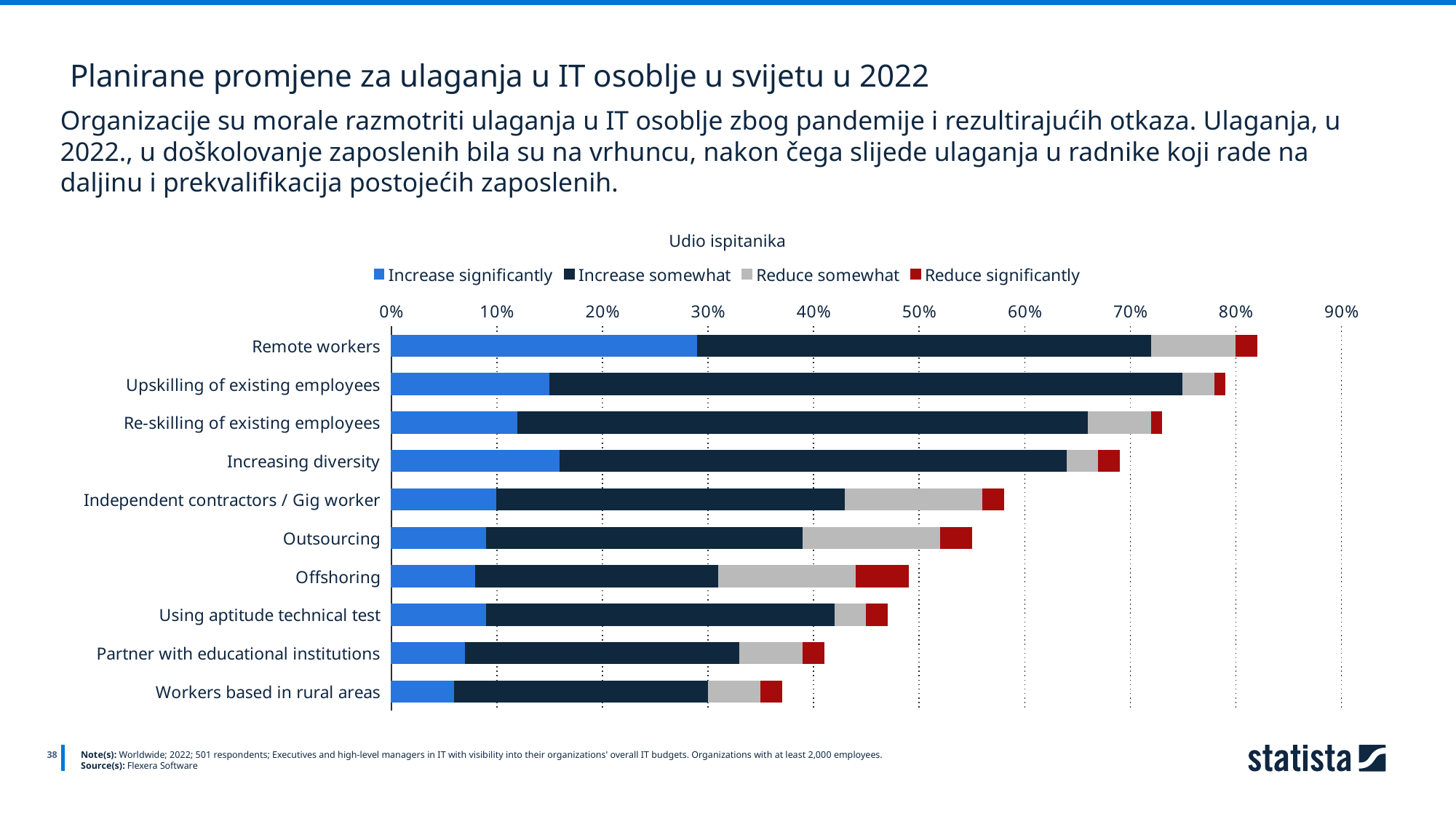
What kind of chart is shown on the slide? Stacked bar chart Which category has the shortest total bar? Workers based in rural areas How many categories are plotted on the chart? 10 Is the 'Increase significantly' value for Workers based in rural areas greater or less than 10%? less Is the 'Increase significantly' value for Remote workers greater or less than 20%? greater Which is larger, the 'Increase significantly' segment for Remote workers or for Upskilling of existing employees? Remote workers Which category has the largest 'Increase significantly' segment? Remote workers Is the total bar for Partner with educational institutions greater or less than 50%? less What is the first series listed in the legend? Increase significantly Which category has the longest total bar? Remote workers Which category has the largest 'Reduce significantly' segment? Offshoring How many series does the legend list? 4